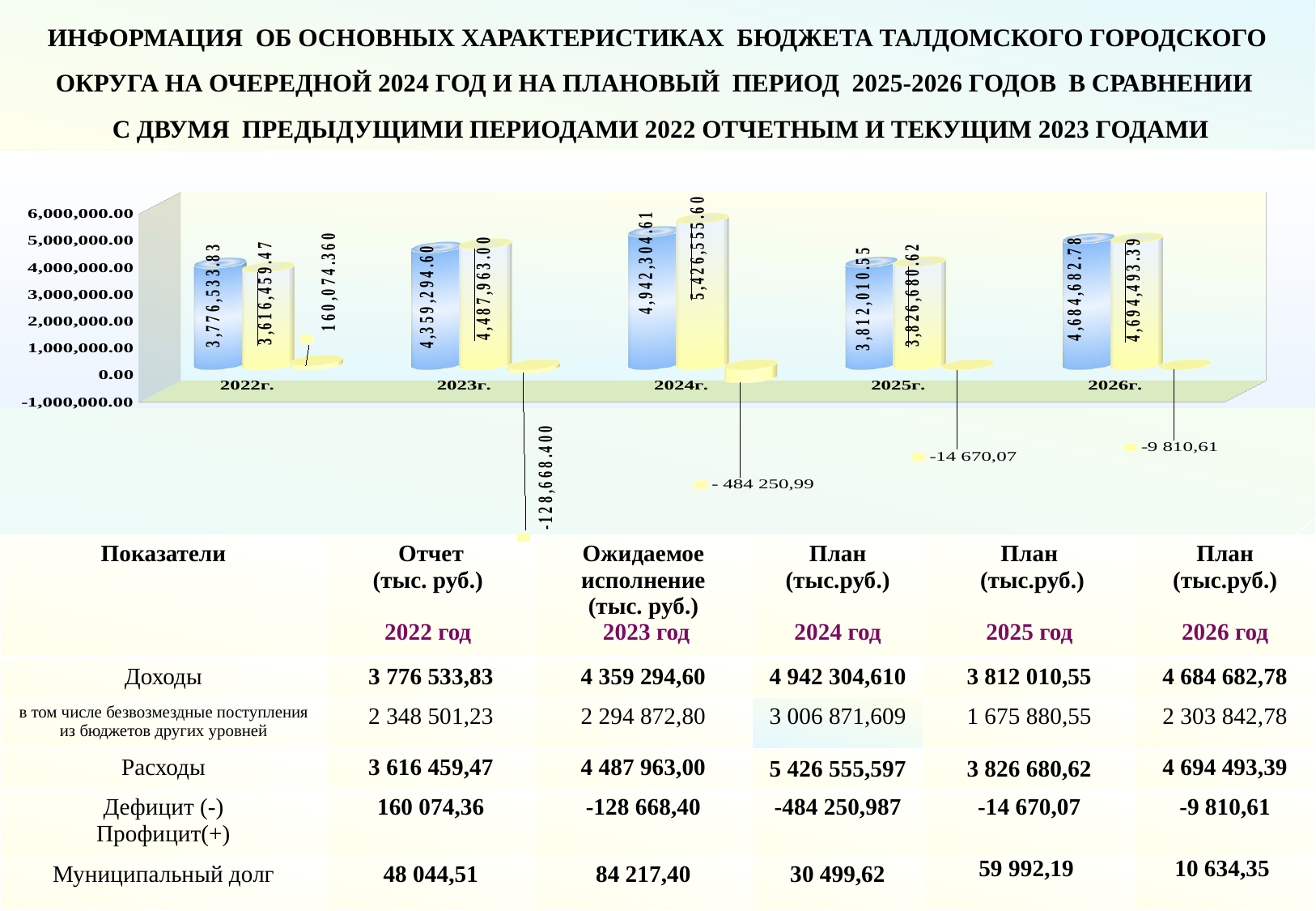
What value is labelled for the small third bar in 2025г.? -14 670,07 What is the value labelled on the small third bar for 2022г.? 160,074.360 What is the value labelled on the blue bar for 2022г.? 3,776,533.83 Do the blue bars rise or fall from 2022г. to 2024г.? rise In 2023г., which is larger: the blue bar or the yellow bar? the yellow bar What is the value labelled on the yellow bar for 2024г.? 5,426,555.60 How many year categories are shown on the x axis of the chart? 5 What kind of chart is shown on the slide? bar chart In which year is the blue bar the tallest? 2024г. What is the difference between the yellow bar and the blue bar in 2024г.? 484,250.99 Is the value of the blue bar for 2024г. greater or less than 4,000,000.00? greater In which year is the yellow bar the shortest? 2022г.